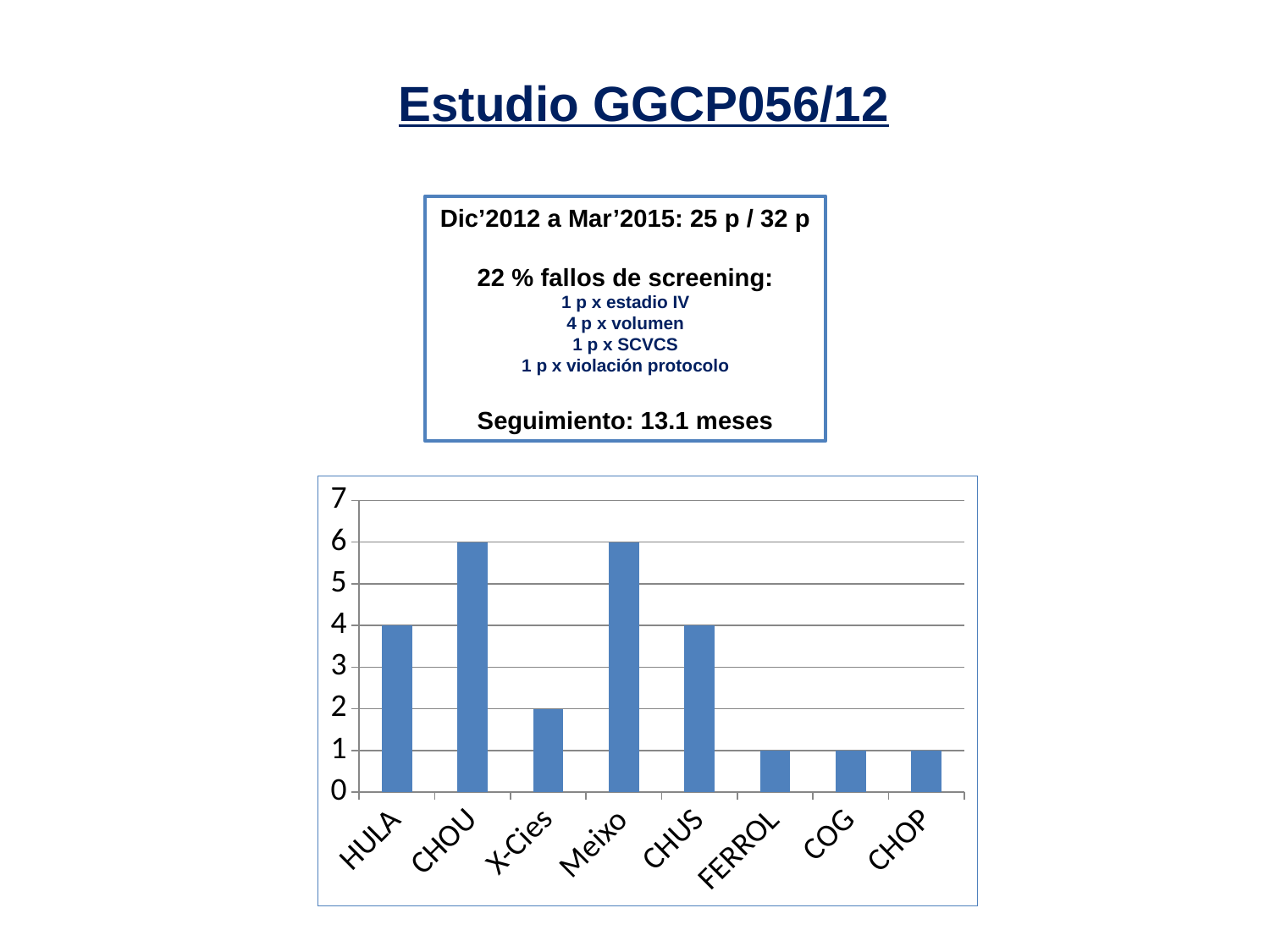
Which is larger, the value for CHOU or the value for X-Cies? CHOU How many categories are shown on the x axis of the chart? 8 What is the highest value on the y axis of the chart? 7 Is the value for HULA greater or less than 3? greater Which is larger, the value for CHUS or the value for COG? CHUS What is the value for Meixo? 6 What is the value for HULA? 4 What kind of chart is shown on the slide? bar chart What is the value for X-Cies? 2 What is the difference between the values for CHOU and X-Cies? 4 What is the value for FERROL? 1 What is the value for CHOU? 6